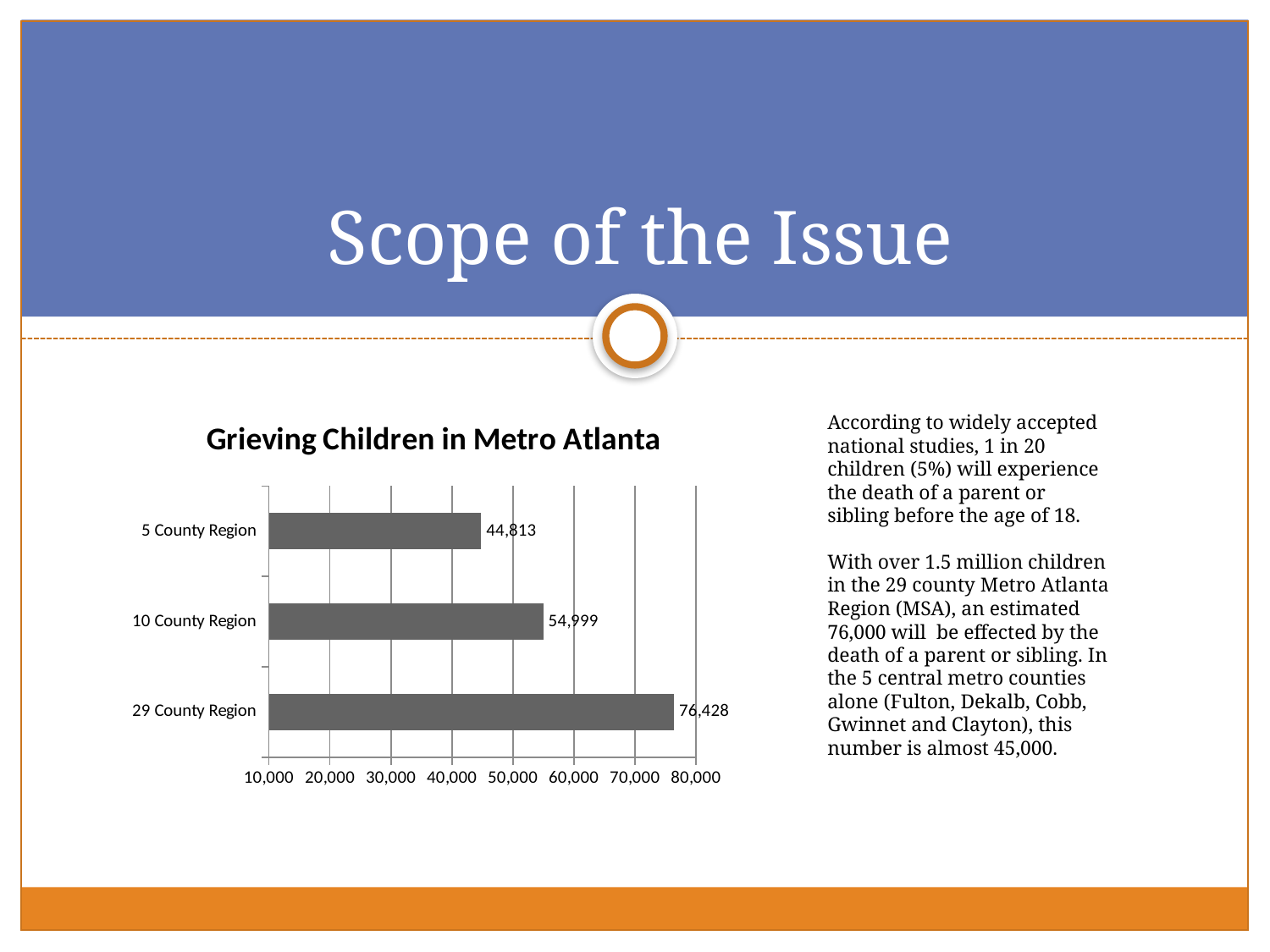
What is the value for the 10 County Region? 54,999 Which is larger, the value for the 10 County Region or the 5 County Region? 10 County Region What is the difference between the 29 County Region and the 5 County Region values? 31,615 Is the value for the 29 County Region greater or less than 70,000? greater How many regions are shown in the chart? 3 Which region has the highest value? 29 County Region Which region has the lowest value? 5 County Region What is the value for the 5 County Region? 44,813 What is the difference between the 10 County Region and the 5 County Region values? 10,186 What is the value for the 29 County Region? 76,428 What is the title of the chart? Grieving Children in Metro Atlanta What kind of chart is shown on the slide? bar chart